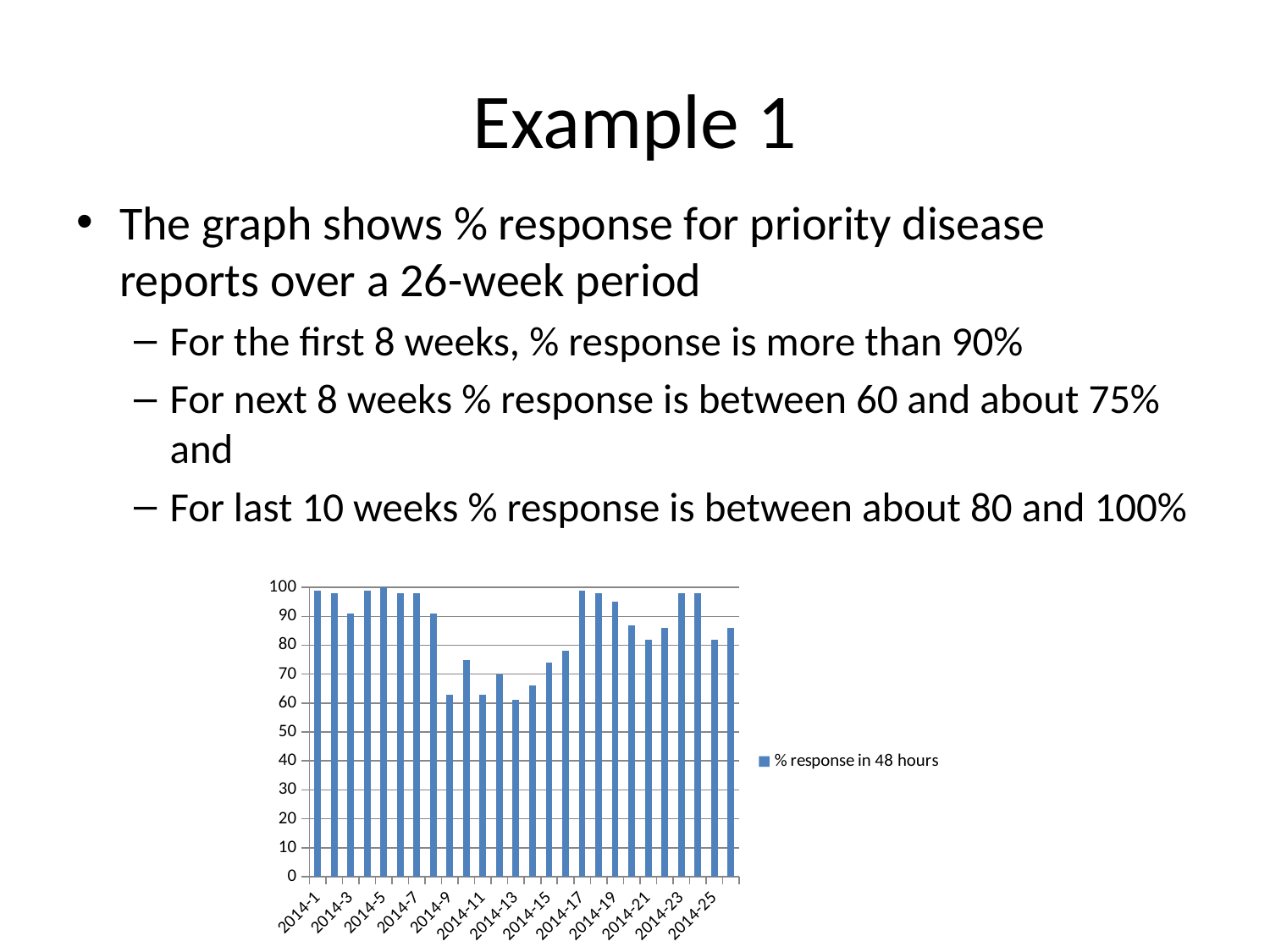
Is the value for 2014-9 greater or less than 60? greater How many series does the legend list? 1 What is the legend entry for the series in the chart? % response in 48 hours Which has the larger value, 2014-1 or 2014-9? 2014-1 What kind of chart is shown on the slide? bar chart Do the values rise or fall from 2014-13 to 2014-17? rise Is the value for 2014-19 greater or less than 90? greater Which has the larger value, 2014-13 or 2014-17? 2014-17 How many bars (weeks) are plotted in the chart? 26 Is the value for 2014-13 greater or less than 70? less